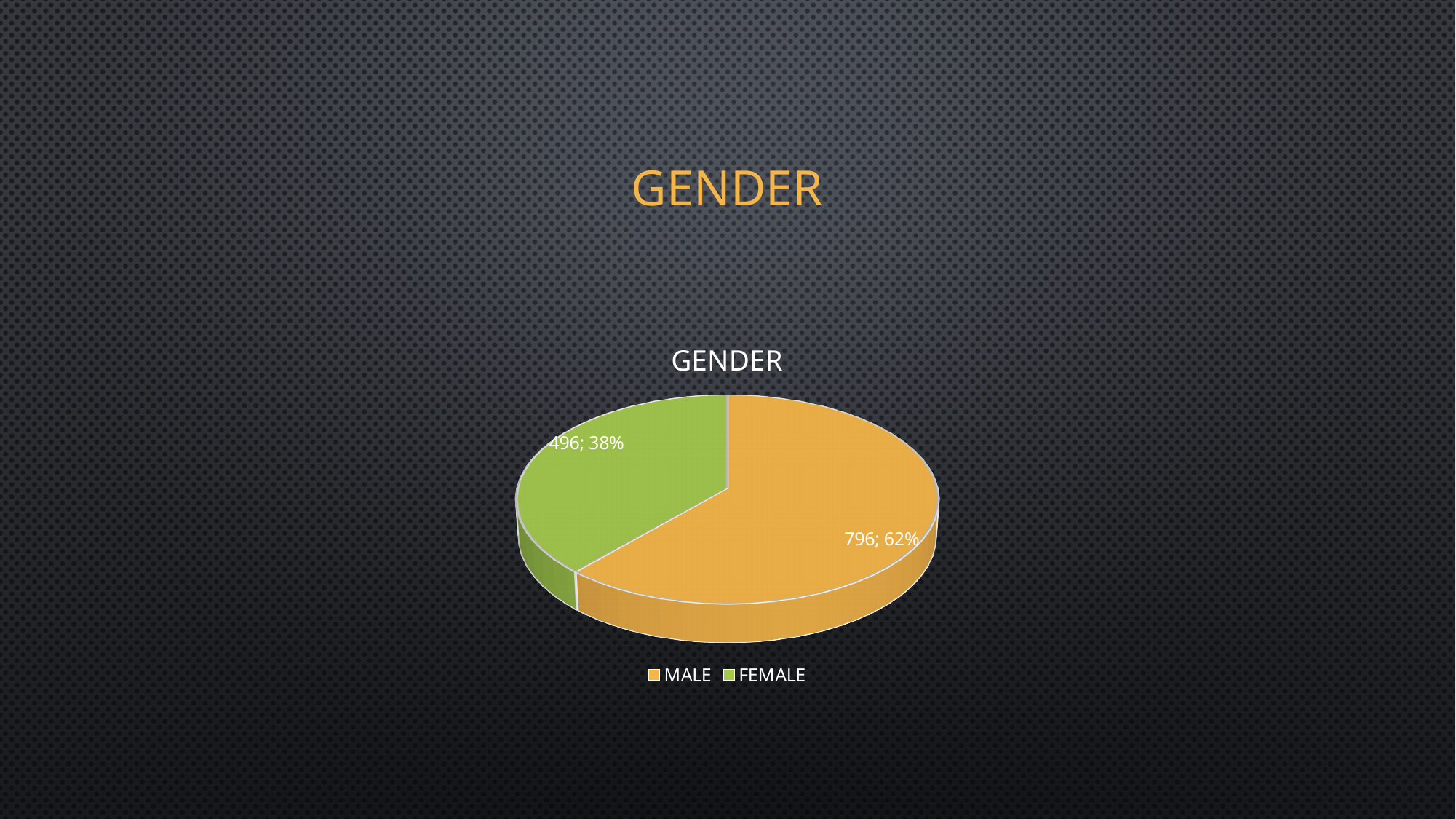
Which category has the largest slice? MALE What is the difference between the MALE and FEMALE counts? 300 What is the count for MALE? 796 What is the count for FEMALE? 496 What is the title of the chart? GENDER What share of the pie does the MALE slice represent? 62% What share of the pie does the FEMALE slice represent? 38% What type of chart is shown on the slide? pie chart Which category has the smallest slice? FEMALE How many entries does the legend list? 2 Which colour represents FEMALE in the chart? green How many slices does the pie chart have? 2